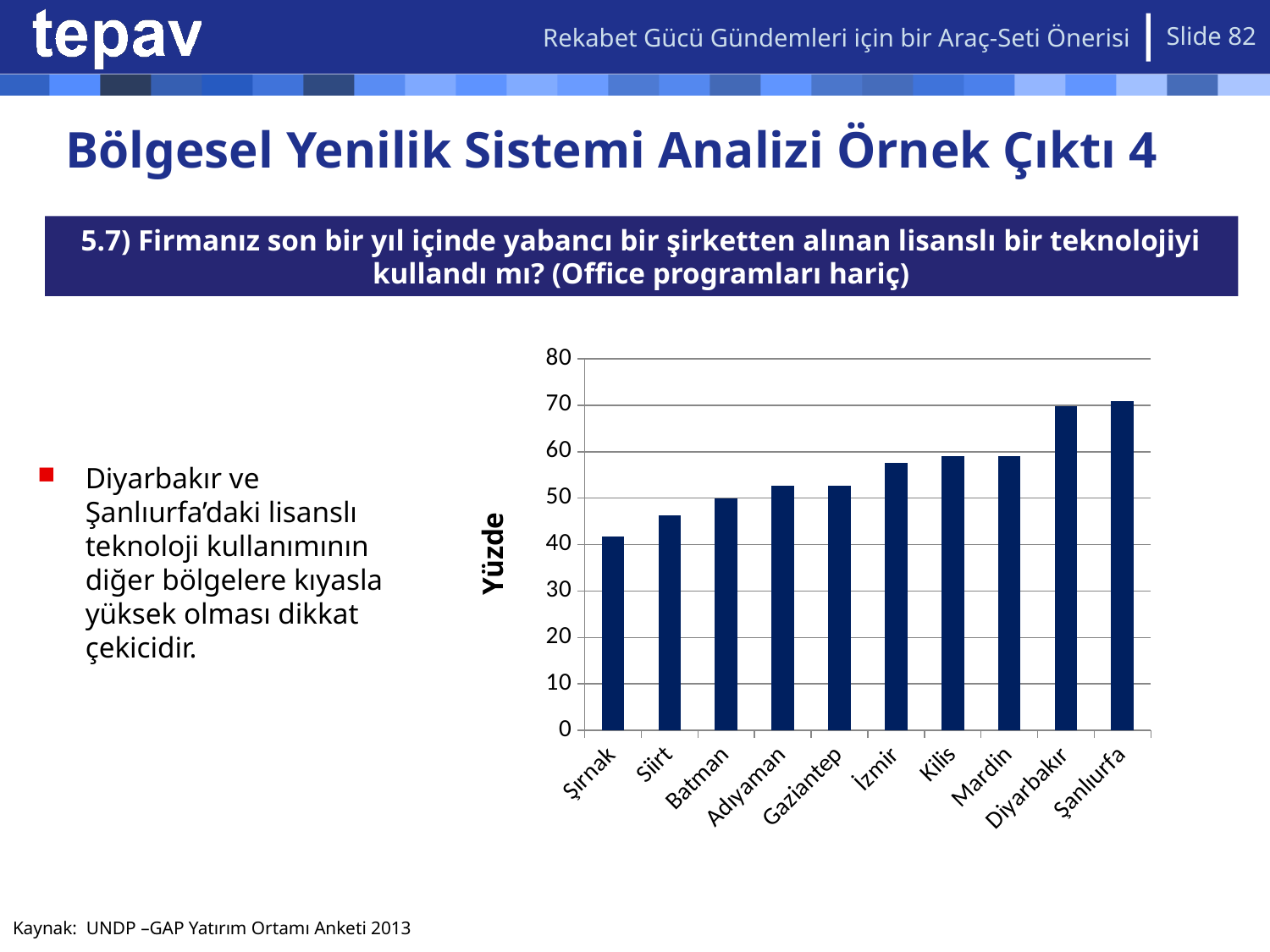
What kind of chart is shown on the slide? bar chart Which is larger, the value for Siirt or the value for Şırnak? Siirt Do the bar values rise or fall moving from left to right along the x axis? rise Which is larger, the value for Batman or the value for Diyarbakır? Diyarbakır Is the value for Siirt greater or less than 50? less Is the value for Diyarbakır greater or less than 60? greater Is the value for İzmir greater or less than 50? greater Which province has the lowest value in the chart? Şırnak What is the label of the vertical axis of the chart? Yüzde How many provinces (categories) are shown on the x axis of the chart? 10